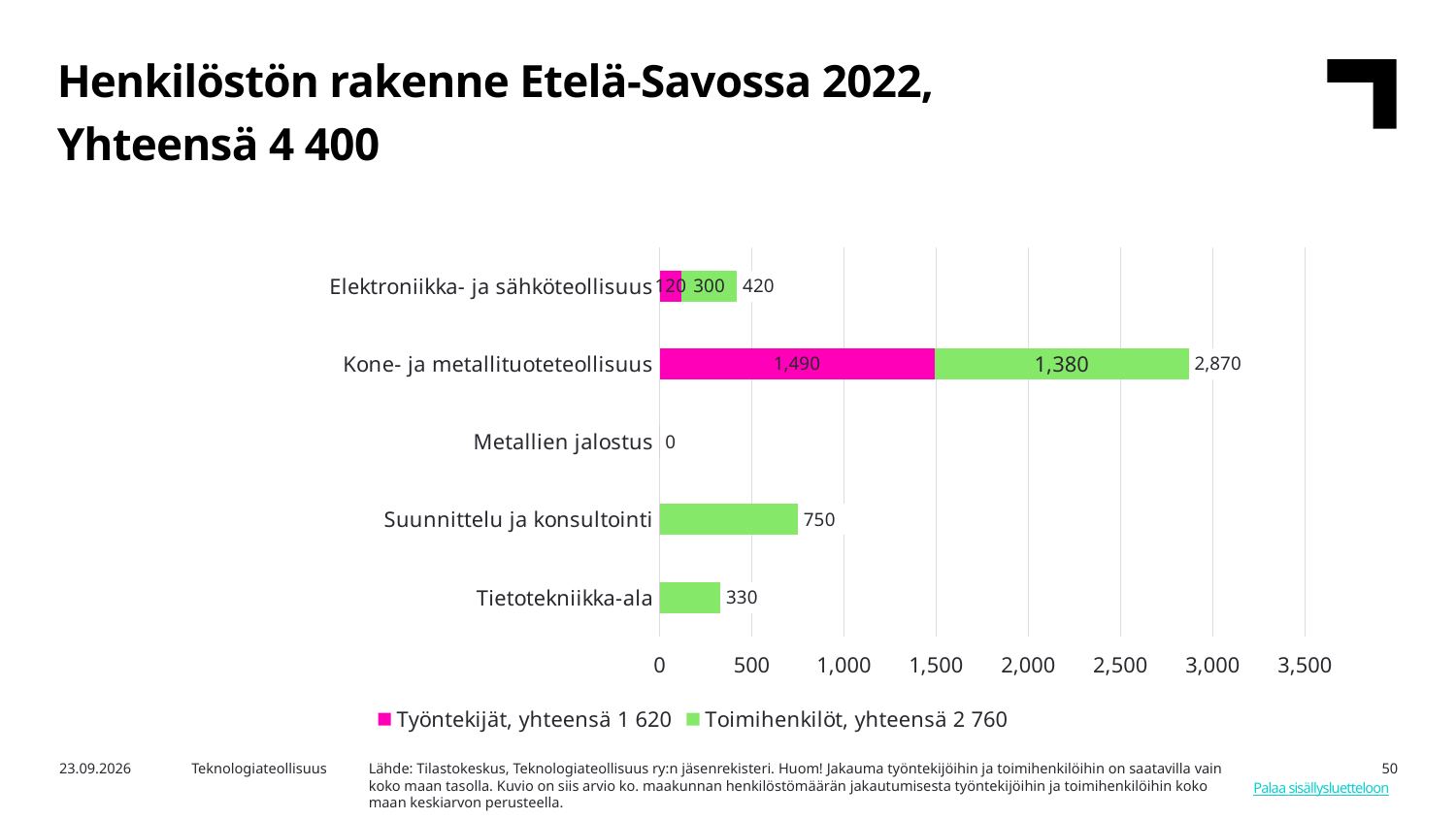
What is the difference between the Työntekijät and Toimihenkilöt values for Kone- ja metallituoteteollisuus? 110 What is the value for Tietotekniikka-ala? 330 Which is larger: the value for Suunnittelu ja konsultointi or the value for Tietotekniikka-ala? Suunnittelu ja konsultointi How many series does the legend list? 2 What is the Työntekijät value for Kone- ja metallituoteteollisuus? 1,490 How many categories are shown on the chart? 5 Which category has the lowest total? Metallien jalostus What type of chart is shown on the slide? bar chart What is the total shown for Elektroniikka- ja sähköteollisuus? 420 Which category has the highest total? Kone- ja metallituoteteollisuus What is the Toimihenkilöt value for Kone- ja metallituoteteollisuus? 1,380 What is the value for Suunnittelu ja konsultointi? 750